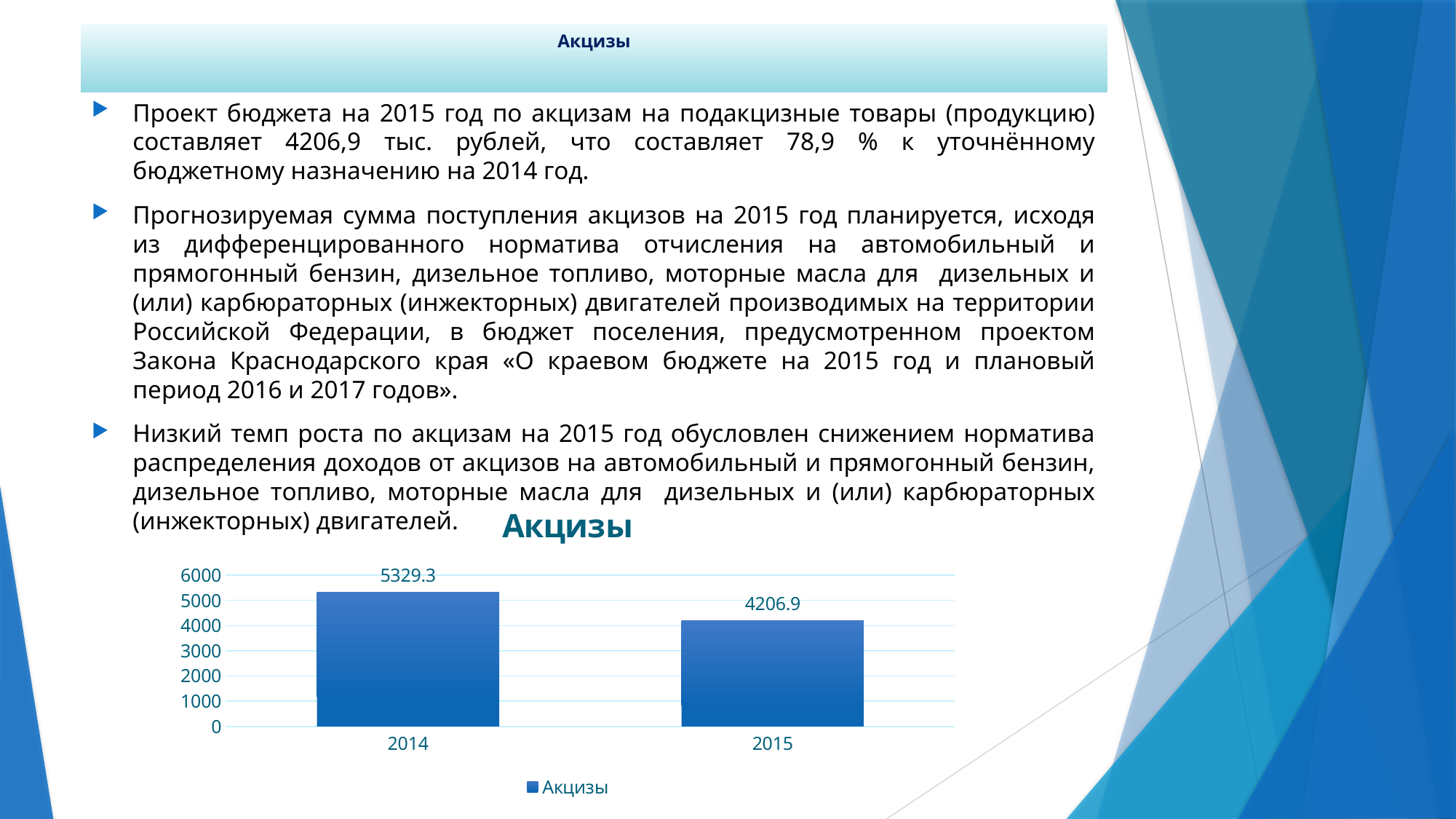
What is the difference between the values for 2014 and 2015? 1122.4 Do the values rise or fall from 2014 to 2015? fall How many categories are shown on the x axis of the chart? 2 How many series does the chart legend list? 1 Is the value for 2015 greater or less than 5000? less What kind of chart is shown on the slide? bar chart Is the value for 2014 greater or less than 5000? greater Which year has the lowest value in the chart? 2015 What is the value for 2014 in the chart? 5329.3 Which year has the highest value in the chart? 2014 What is the value for 2015 in the chart? 4206.9 Which is larger, the value for 2014 or the value for 2015? 2014